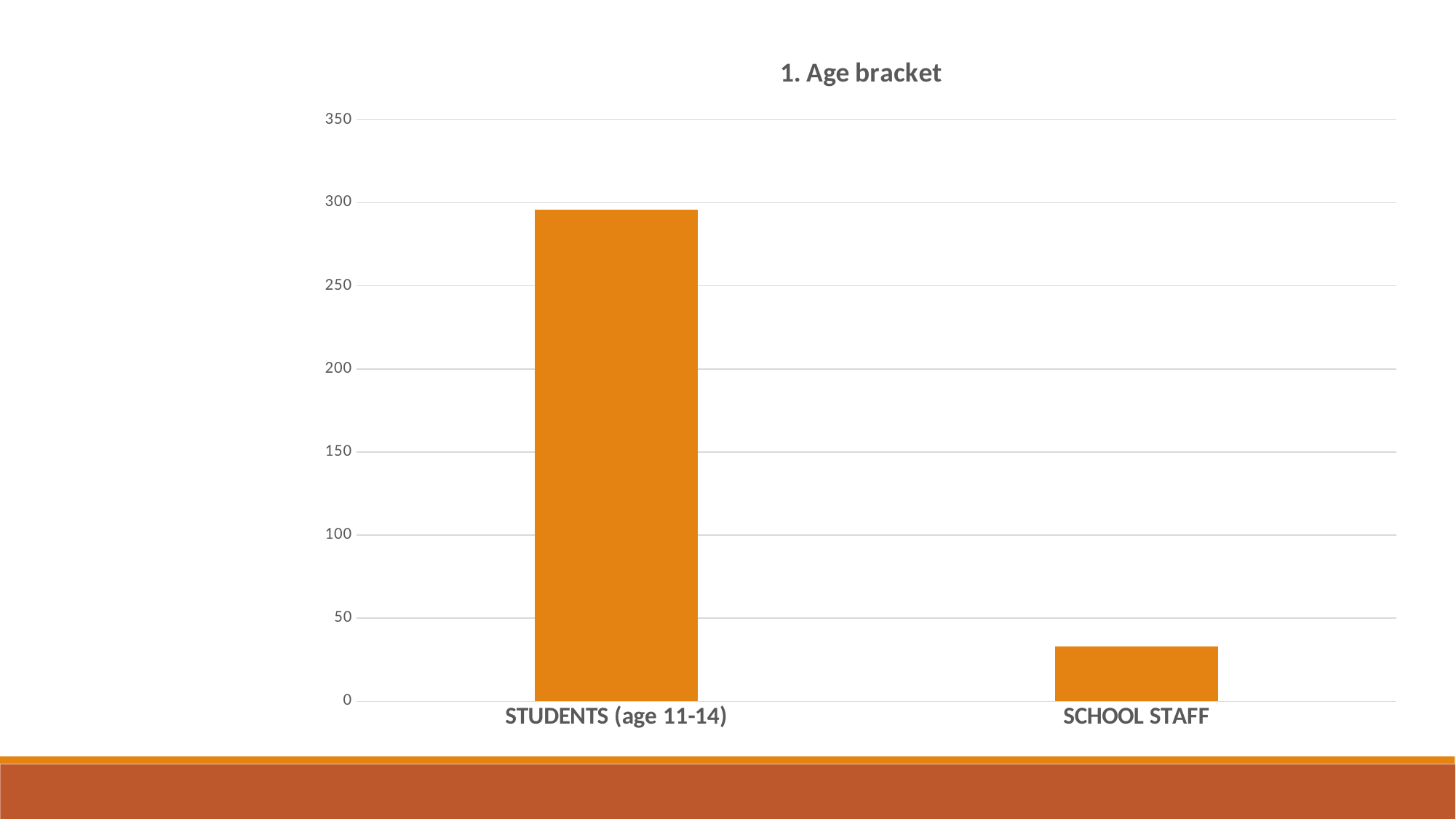
Is the value for STUDENTS (age 11-14) greater or less than 250? greater How many categories are shown on the x axis? 2 Is the value for SCHOOL STAFF greater or less than 50? less Which category has the lowest value? SCHOOL STAFF What is the highest value shown on the vertical axis? 350 What is the title of the chart? 1. Age bracket What kind of chart is shown on the slide? bar chart Which category has the highest value? STUDENTS (age 11-14) Is the value for SCHOOL STAFF greater or less than 0? greater Do the values rise or fall from left to right along the x axis? fall Which is larger, the value for STUDENTS (age 11-14) or the value for SCHOOL STAFF? STUDENTS (age 11-14)